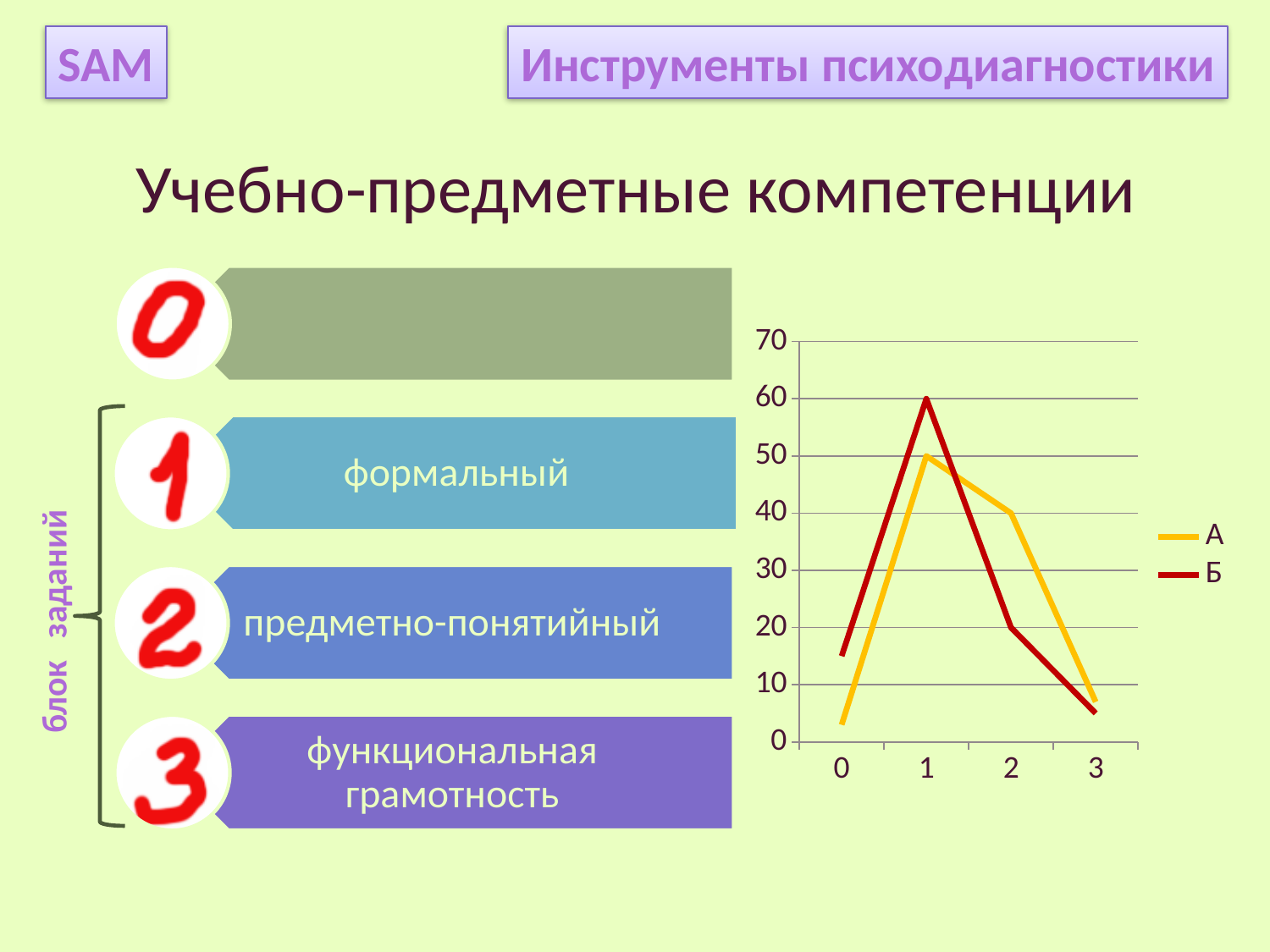
Which two series names appear in the chart legend? А and Б How many points are plotted along the x axis for each series? 4 What is the value of series Б at x = 2? 20 What kind of chart is shown on the slide? line chart Is the value for series Б at x = 0 greater or less than 10? greater What is the difference between series Б and series A at x = 1? 10 What is the value of series A at x = 2? 40 What is the value of series A at x = 1? 50 What is the value of series Б at x = 1? 60 At x = 2, which series has the larger value, A or Б? A How many series does the chart legend list? 2 At which x value does series Б reach its highest point? 1